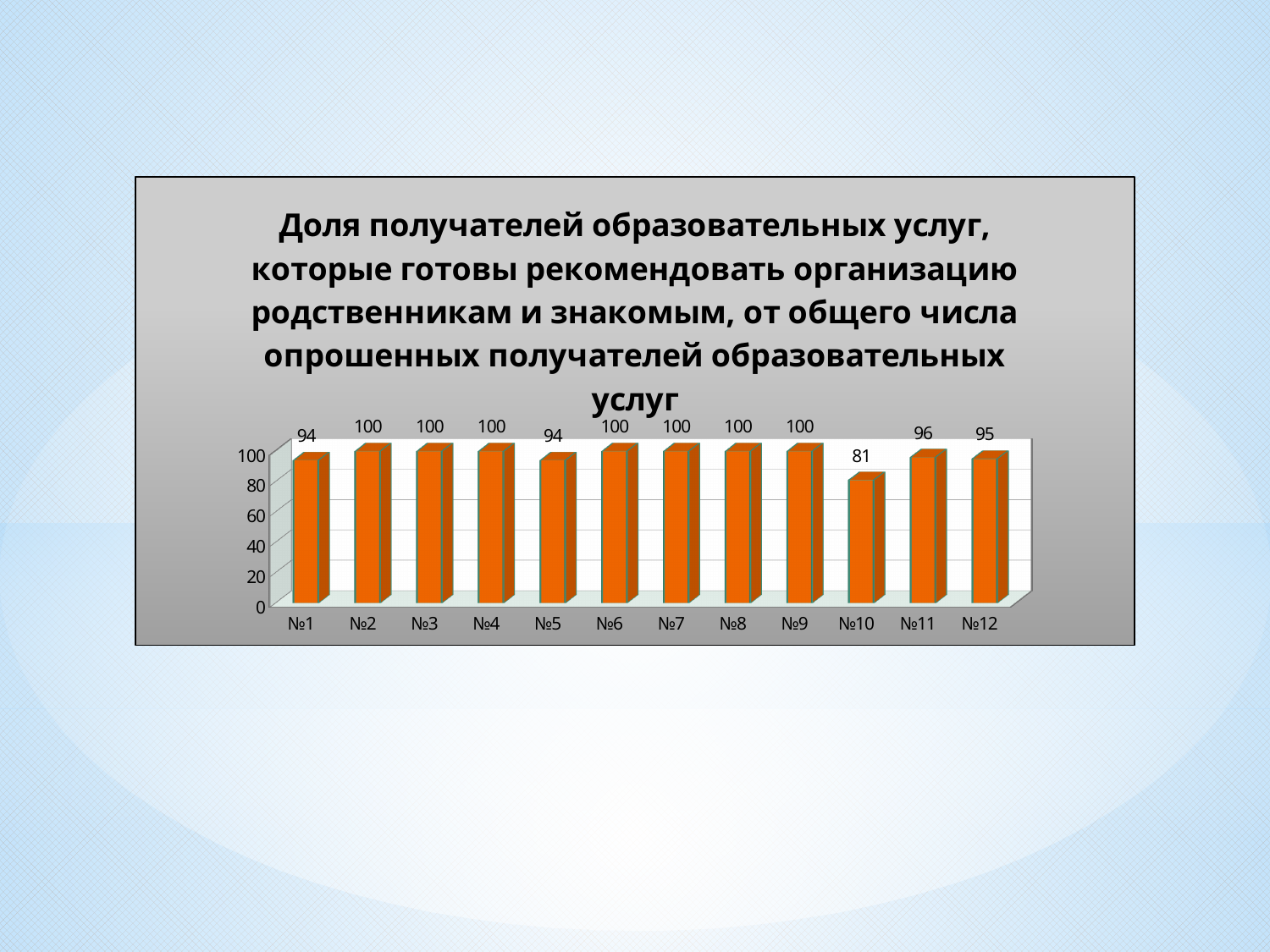
How many categories have a value of 100? 7 Which category has the lowest value? №10 How many categories are shown on the x axis? 12 What is the value for №10? 81 What is the value for №11? 96 What kind of chart is shown on the slide? bar chart What is the value for №1? 94 Which is larger, the value for №12 or the value for №10? №12 What is the value for №12? 95 What is the difference between the values for №11 and №5? 2 Is the value for №10 greater or less than 80? greater What is the difference between the values for №2 and №10? 19